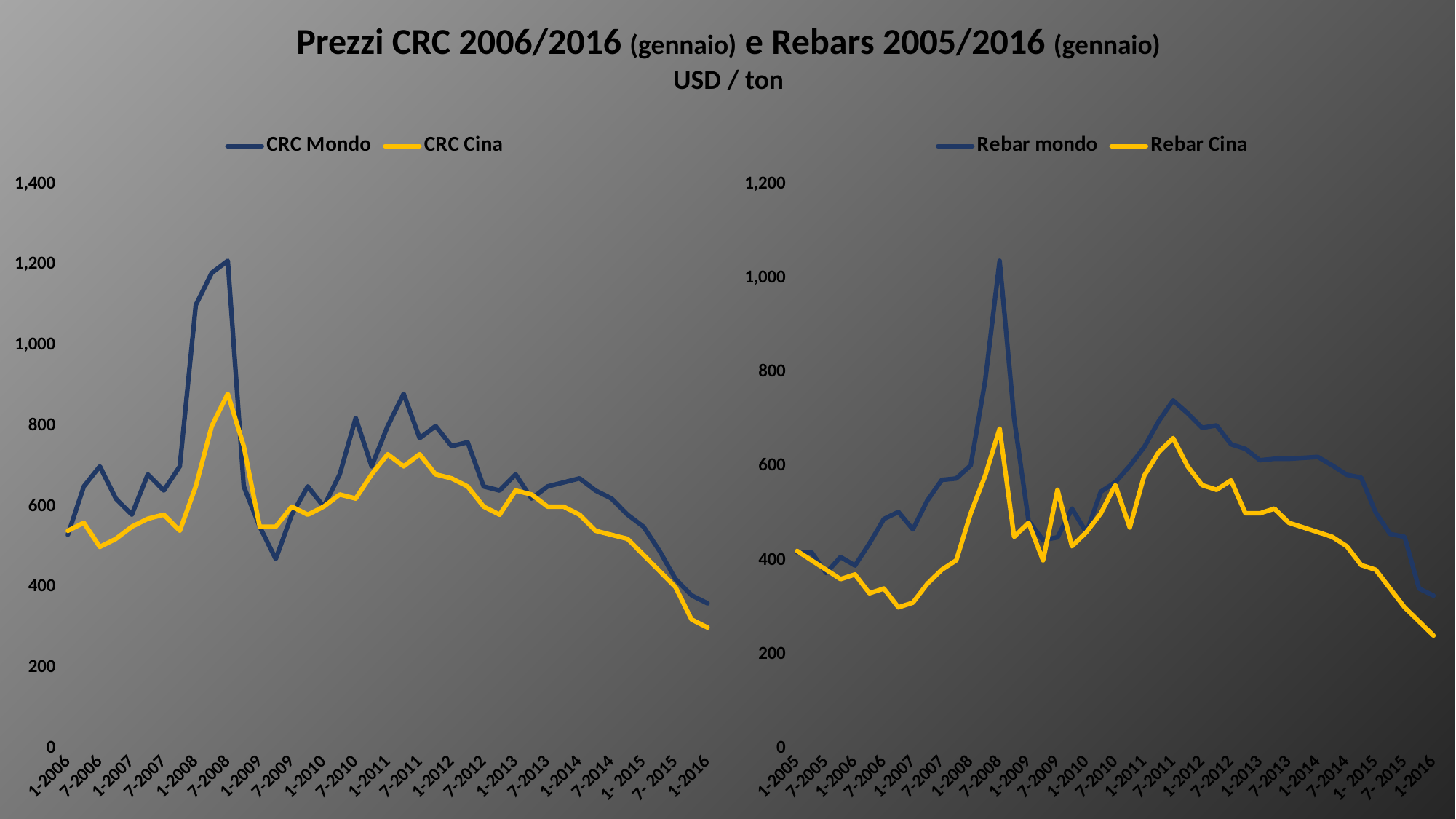
In the left chart, which series has the higher value at 7-2008, CRC Mondo or CRC Cina? CRC Mondo How many series does the legend of the right chart (Rebar mondo / Rebar Cina) list? 2 In the right chart, which series has the higher value at 1-2016, Rebar mondo or Rebar Cina? Rebar mondo In the right chart, which colour is used for the Rebar Cina series? Yellow In the right chart, is the value of Rebar Cina at 1-2016 greater or less than 400? less What kind of chart is the left chart (CRC Mondo / CRC Cina)? Line chart In the right chart, is the peak value of Rebar mondo around 7-2008 greater or less than 800? greater In the left chart, is the peak value of CRC Mondo around 7-2008 greater or less than 1,000? greater In the right chart, does Rebar Cina rise or fall between 7-2011 and 1-2016? Fall What unit is stated in the subtitle of the slide? USD / ton In the left chart, does CRC Mondo rise or fall between 7-2011 and 1-2016? Fall